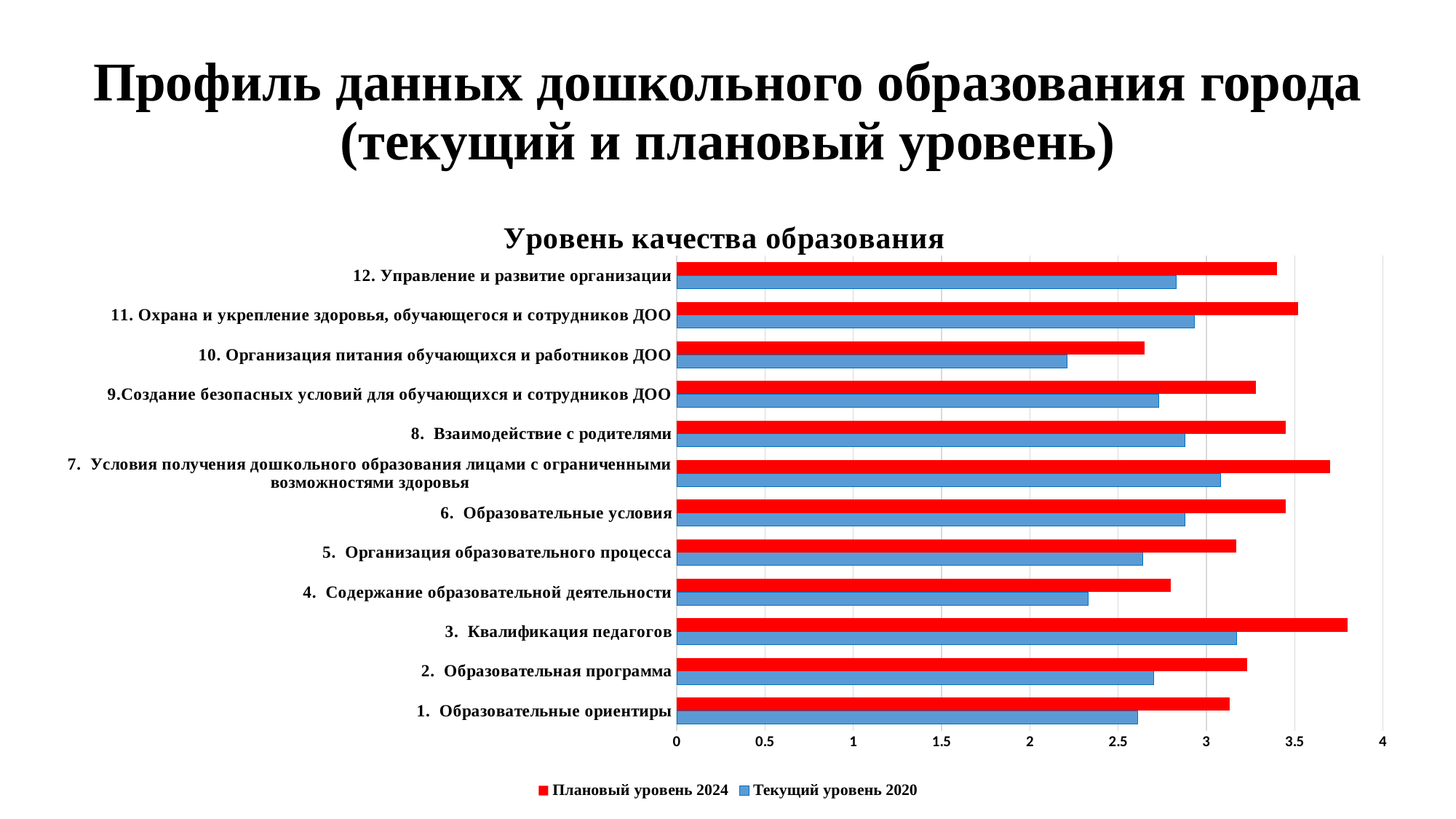
Is the "Плановый уровень 2024" value for "3. Квалификация педагогов" greater or less than 3.5? greater Is the "Текущий уровень 2020" value for "4. Содержание образовательной деятельности" greater or less than 2.5? less Which category has the lowest value for "Плановый уровень 2024"? 10. Организация питания обучающихся и работников ДОО Which category has the lowest value for "Текущий уровень 2020"? 10. Организация питания обучающихся и работников ДОО How many series does the legend of the chart list? 2 For "8. Взаимодействие с родителями", which is larger: "Плановый уровень 2024" or "Текущий уровень 2020"? Плановый уровень 2024 What are the two series named in the chart legend? Плановый уровень 2024 and Текущий уровень 2020 Which category has the highest value for "Плановый уровень 2024"? 3. Квалификация педагогов Is the "Плановый уровень 2024" value for "10. Организация питания обучающихся и работников ДОО" greater or less than 3? less Which colour represents "Текущий уровень 2020" in the chart? Blue What kind of chart is shown on the slide? Bar chart How many categories are shown on the chart "Уровень качества образования"? 12